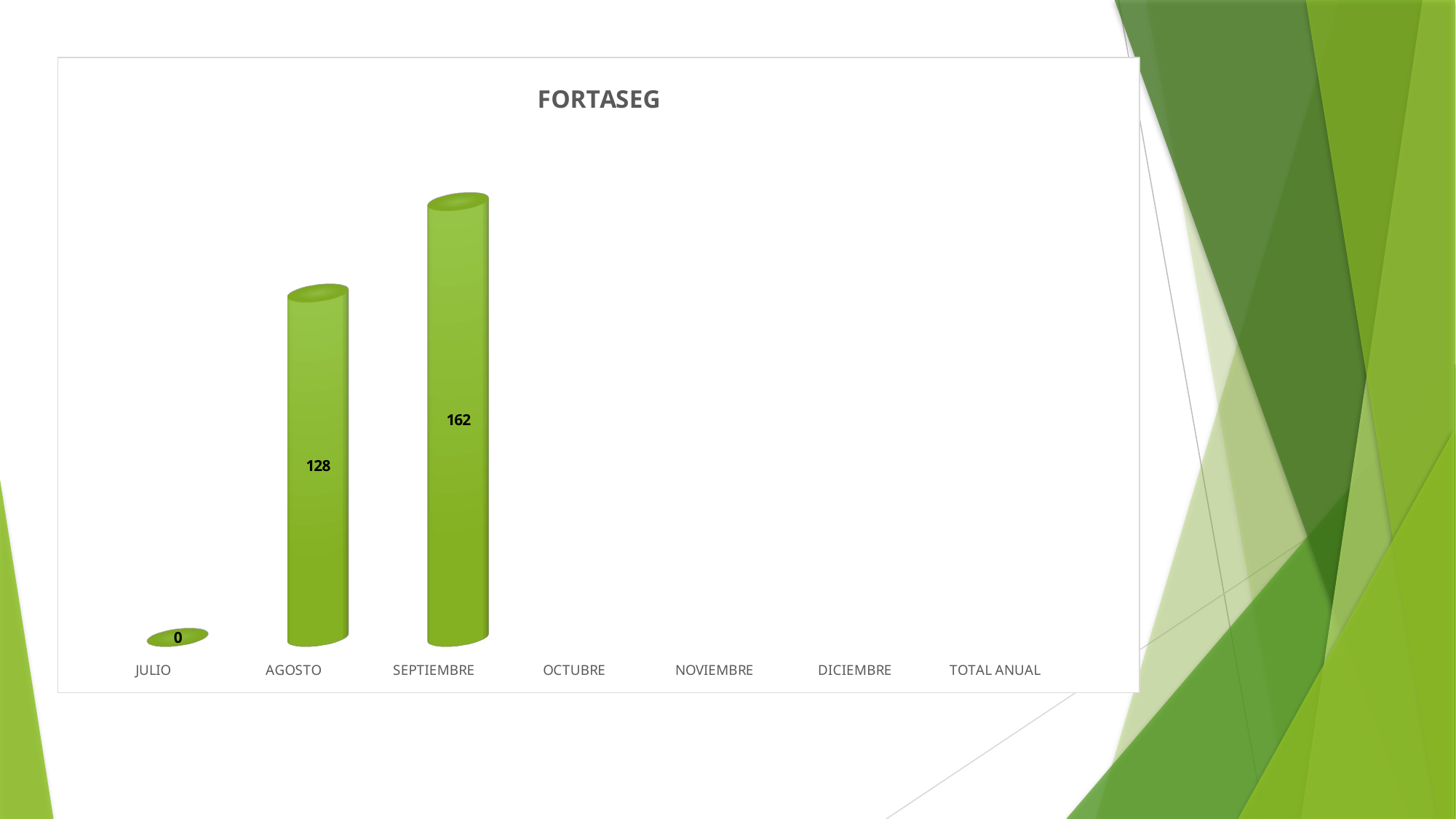
What is the value for JULIO? 0 What is the difference between the values for SEPTIEMBRE and AGOSTO? 34 What is the label of the last category on the x axis? TOTAL ANUAL Do the values rise or fall from JULIO to SEPTIEMBRE? rise What is the value for SEPTIEMBRE? 162 Which is larger, the value for AGOSTO or the value for SEPTIEMBRE? SEPTIEMBRE What is the title of the chart? FORTASEG What kind of chart is this? bar chart What colour are the bars in the chart? green What is the value for AGOSTO? 128 How many categories are shown on the x axis? 7 Which category has the highest value? SEPTIEMBRE